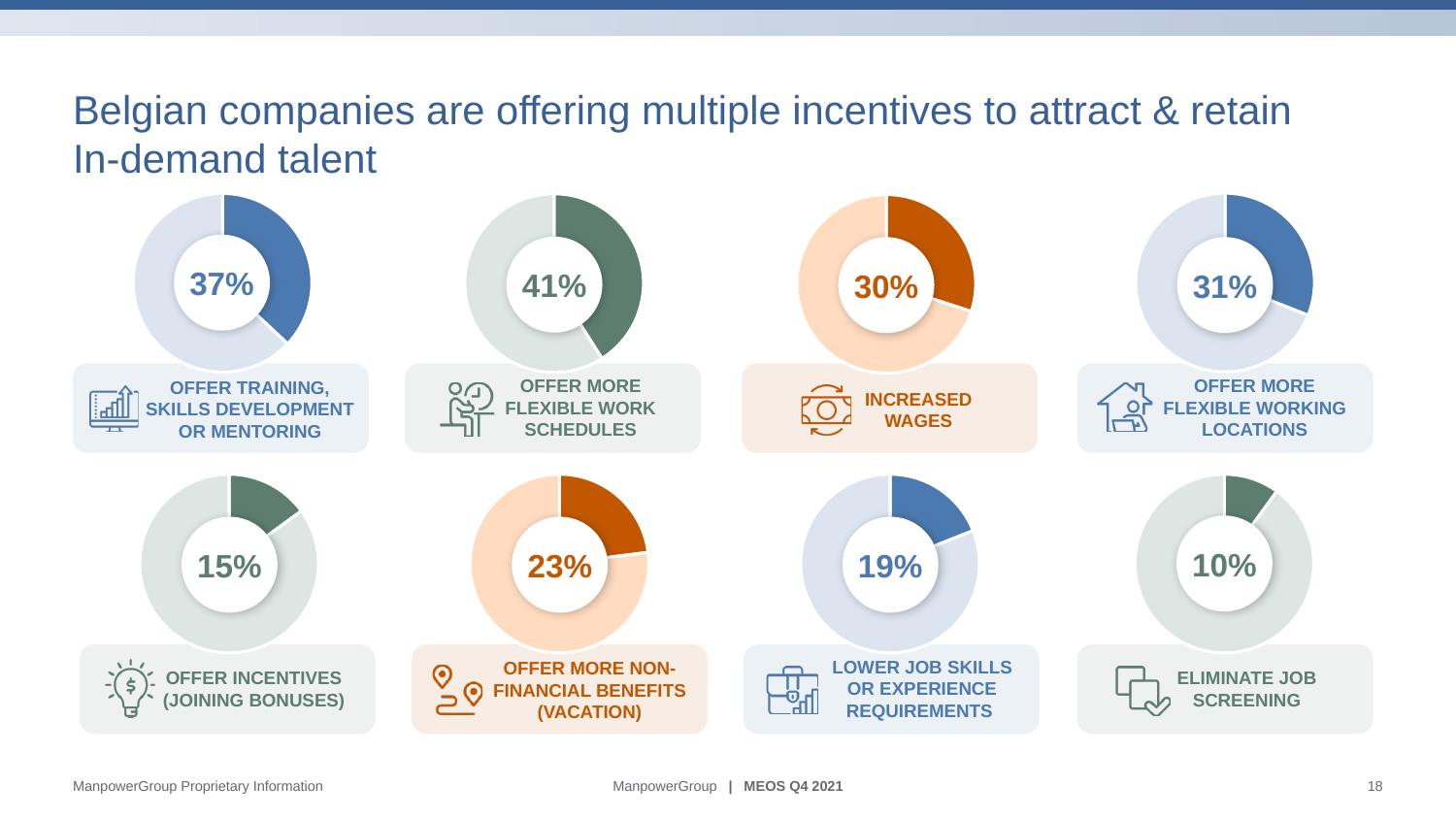
What percentage is shown in the donut chart for "Eliminate job screening"? 10% How many donut charts are shown on the slide? 8 What is the difference between the percentage for "Offer training, skills development or mentoring" and the percentage for "Offer more flexible working locations"? 6% Which incentive has the lowest percentage across the donut charts on the slide? Eliminate job screening What percentage is shown in the donut chart for "Increased wages"? 30% What percentage is shown in the donut chart for "Lower job skills or experience requirements"? 19% What percentage is shown in the donut chart for "Offer incentives (joining bonuses)"? 15% Which incentive has the highest percentage across the donut charts on the slide? Offer more flexible work schedules What type of chart is used to show each incentive's percentage on the slide? Donut chart Which is larger: the percentage for "Offer more non-financial benefits (vacation)" or the percentage for "Lower job skills or experience requirements"? Offer more non-financial benefits (vacation) What percentage is shown in the donut chart for "Offer more flexible work schedules"? 41% What colour is the highlighted segment of the donut chart for "Increased wages"? Orange